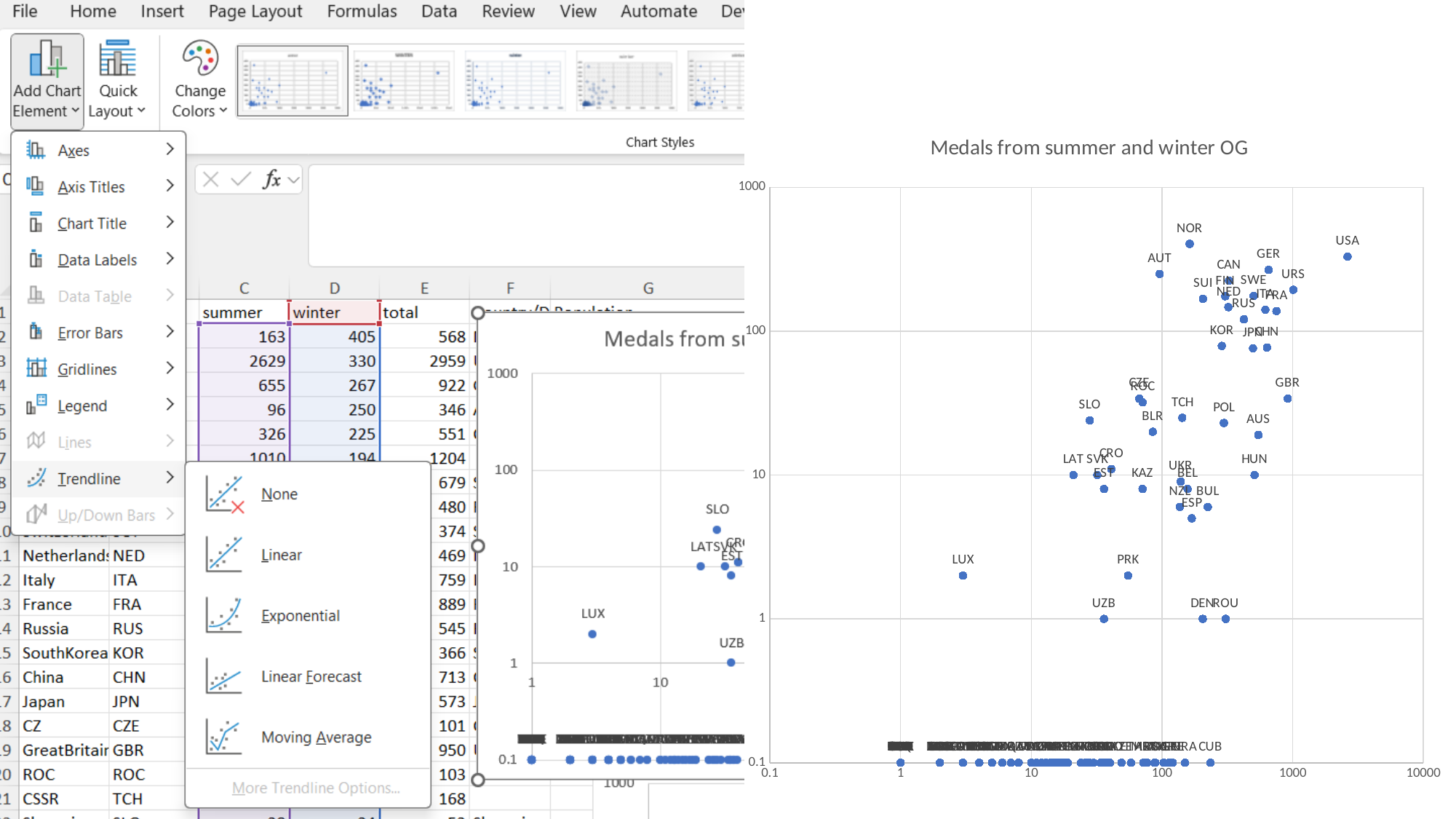
In the "Medals from summer and winter OG" chart, which point is further right on the horizontal axis, USA or LUX? USA In the "Medals from summer and winter OG" chart, which labelled point is furthest to the right on the horizontal axis? USA In the "Medals from summer and winter OG" chart, what vertical-axis value does the UZB point sit on? 1 In the "Medals from summer and winter OG" chart, which point is higher on the vertical axis, NOR or SLO? NOR In the "Medals from summer and winter OG" chart, is the vertical-axis value for USA greater or less than 100? greater In the "Medals from summer and winter OG" chart, is the horizontal-axis value for USA greater or less than 1000? greater What kind of chart is "Medals from summer and winter OG"? scatter chart In the "Medals from summer and winter OG" chart, is the vertical-axis value for LUX greater or less than 10? less In the "Medals from summer and winter OG" chart, what is the highest value shown on the vertical axis? 1000 What is the title of the chart on the right side of the slide? Medals from summer and winter OG